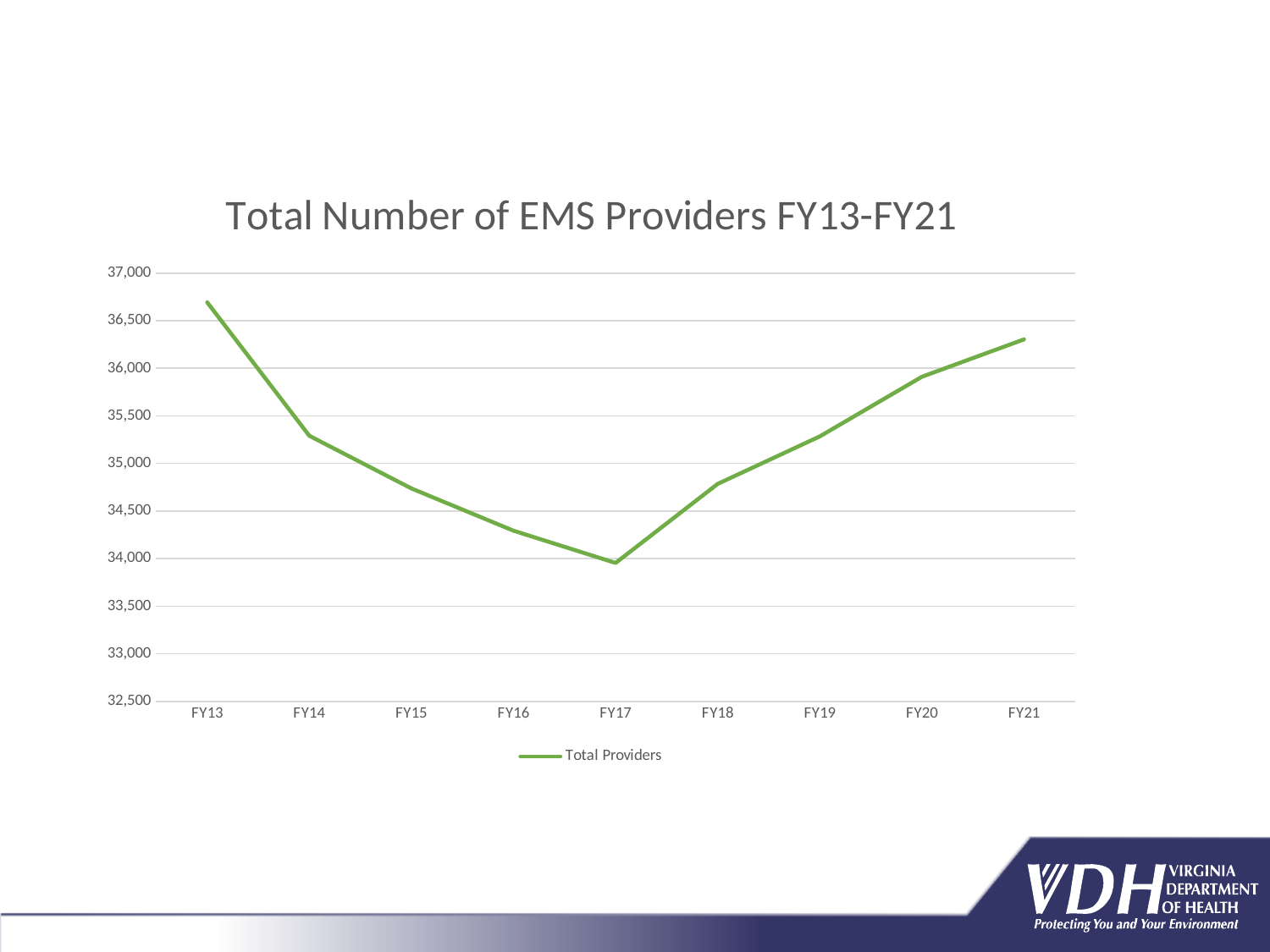
What kind of chart is shown on the slide? line chart Is the value for FY21 greater or less than 36,000? greater How many series does the legend list? 1 Which is larger, the value for FY15 or the value for FY20? FY20 What is the title of the chart? Total Number of EMS Providers FY13-FY21 What is the name of the series shown in the legend? Total Providers In which fiscal year is the total number of providers highest? FY13 Is the value for FY17 greater or less than 34,500? less Is the value for FY13 greater or less than 36,500? greater Does the total number of providers rise or fall from FY13 to FY17? fall In which fiscal year is the total number of providers lowest? FY17 How many fiscal years are plotted on the x axis? 9